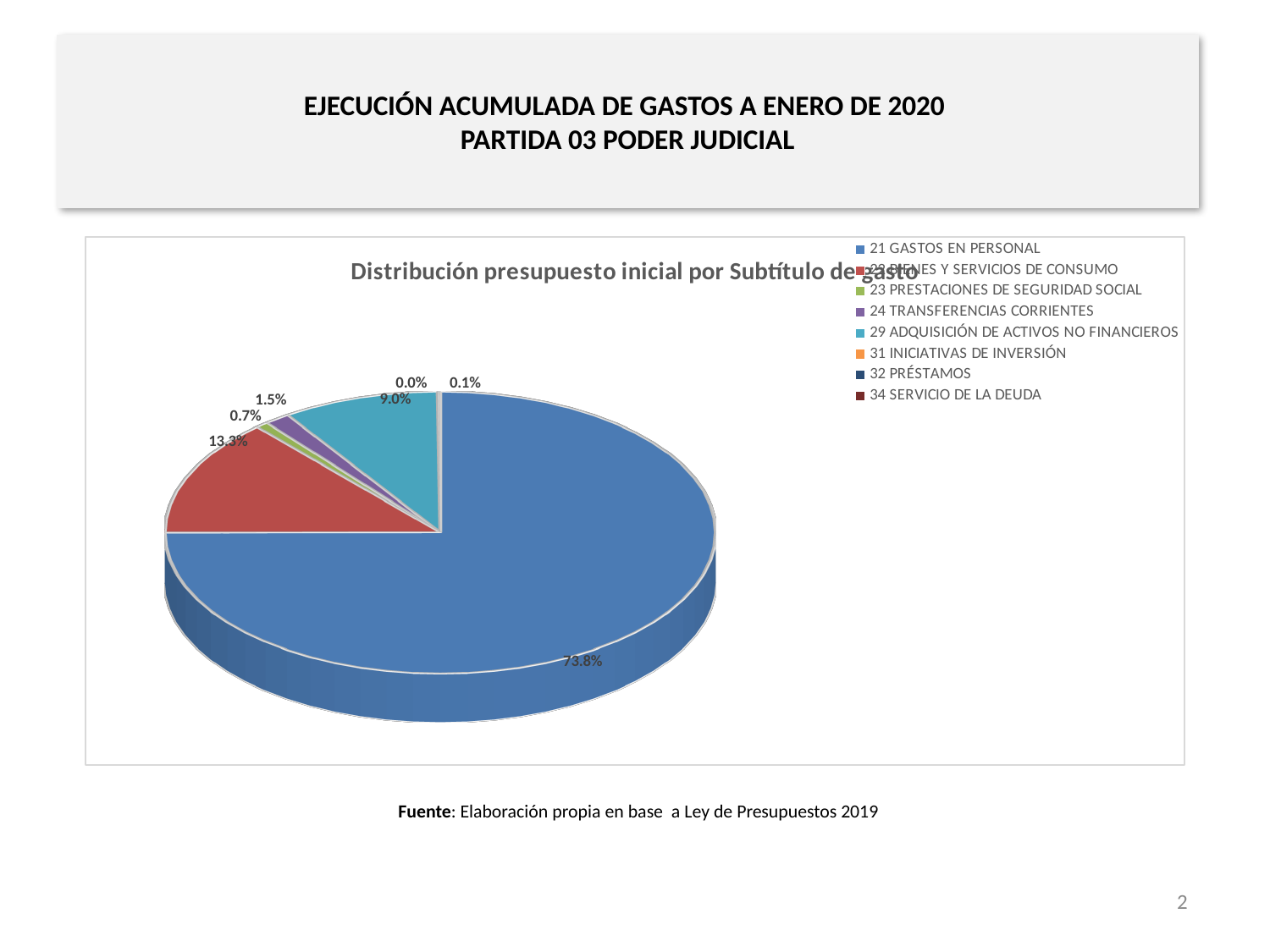
What colour is the slice for 21 GASTOS EN PERSONAL? Blue How many categories does the legend list? 8 What is the title of the chart? Distribución presupuesto inicial por Subtítulo de gasto Which category has the largest share of the pie? 21 GASTOS EN PERSONAL What is the value shown for 24 TRANSFERENCIAS CORRIENTES? 1.5% What kind of chart is shown on the slide? Pie chart What is the value shown for 29 ADQUISICIÓN DE ACTIVOS NO FINANCIEROS? 9.0% What is the value shown for 23 PRESTACIONES DE SEGURIDAD SOCIAL? 0.7% What is the difference in percentage points between the share for 21 GASTOS EN PERSONAL and the share for 22 BIENES Y SERVICIOS DE CONSUMO? 60.5 percentage points Which is larger, the share for 29 ADQUISICIÓN DE ACTIVOS NO FINANCIEROS or for 24 TRANSFERENCIAS CORRIENTES? 29 ADQUISICIÓN DE ACTIVOS NO FINANCIEROS What share of the pie does 21 GASTOS EN PERSONAL have? 73.8% What is the value shown for the red slice, 22 BIENES Y SERVICIOS DE CONSUMO? 13.3%